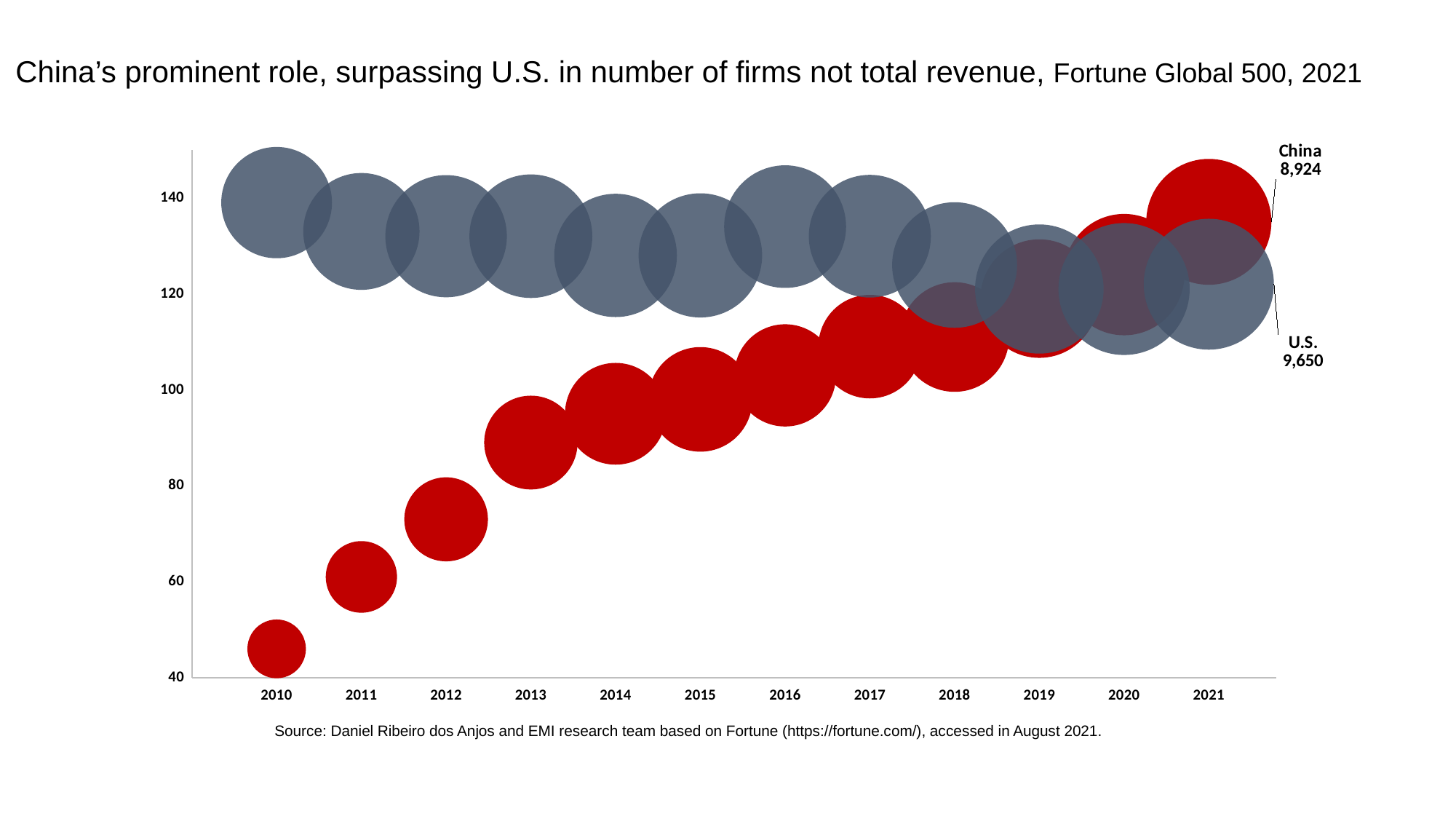
What total revenue value is labelled for China in 2021? 8,924 Does the number of U.S. firms rise or fall from 2010 to 2021? fall In which year does China have its lowest number of firms? 2010 Is the number of Chinese firms in 2010 greater or less than 60? less Is the number of Chinese firms in 2018 greater or less than 100? greater What is the difference between the labelled U.S. revenue (9,650) and China revenue (8,924) in 2021? 726 In 2021, which has more firms, China or the U.S.? China What total revenue value is labelled for the U.S. in 2021? 9,650 Does the number of Chinese firms rise or fall from 2010 to 2021? rise What kind of chart is shown on the slide? bubble chart In 2010, which has more firms, China or the U.S.? U.S. How many years are shown along the x axis? 12